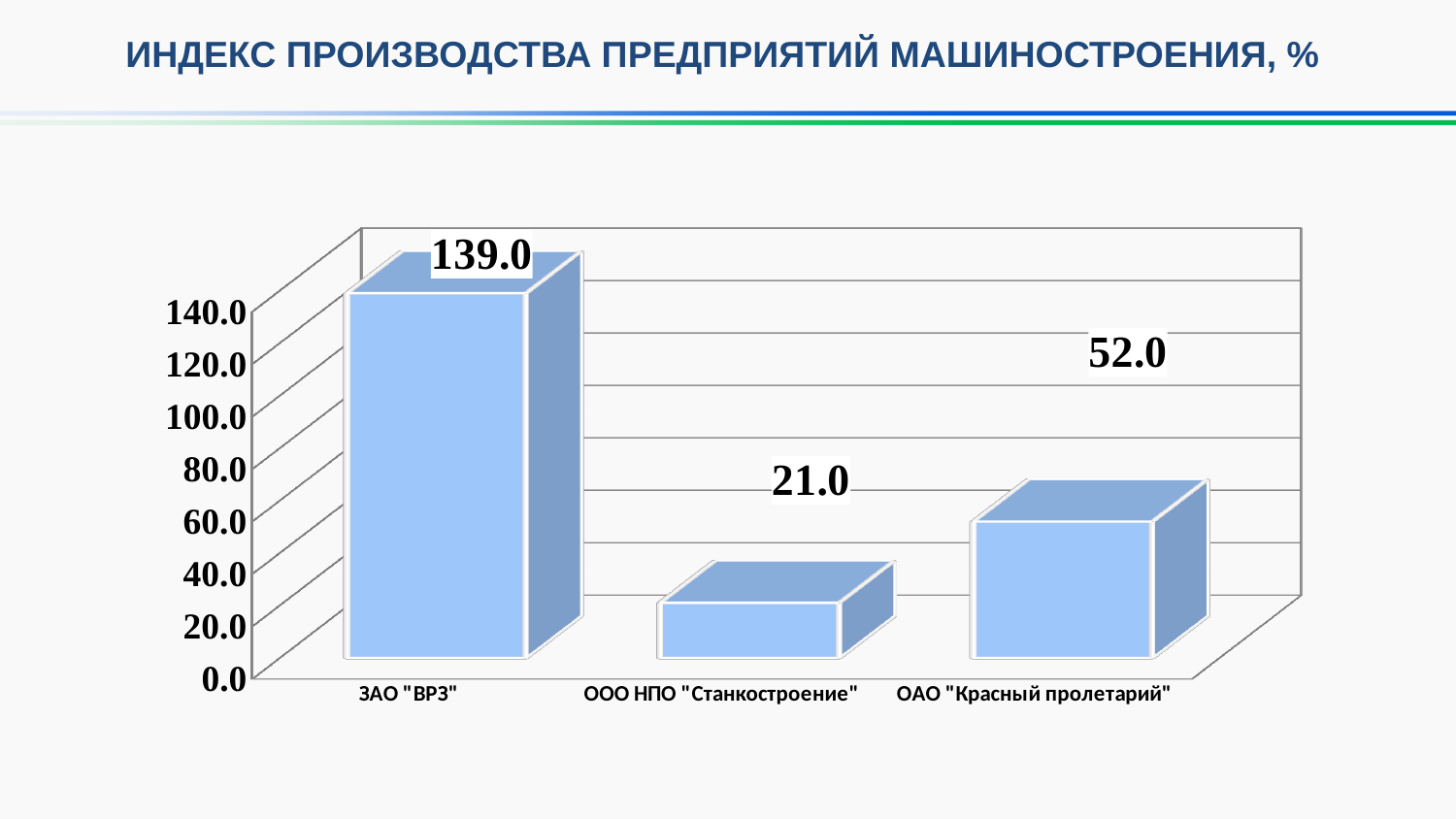
What is the value for ОАО "Красный пролетарий"? 52.0 Which enterprise has the lowest production index? ООО НПО "Станкостроение" What is the difference between the values for ЗАО "ВРЗ" and ОАО "Красный пролетарий"? 87.0 What is the value for ЗАО "ВРЗ"? 139.0 What is the value for ООО НПО "Станкостроение"? 21.0 What is the difference between the values for ОАО "Красный пролетарий" and ООО НПО "Станкостроение"? 31.0 What kind of chart is shown on the slide? bar chart What is the title of the slide? ИНДЕКС ПРОИЗВОДСТВА ПРЕДПРИЯТИЙ МАШИНОСТРОЕНИЯ, % Which enterprise has the highest production index? ЗАО "ВРЗ" How many enterprises are shown on the chart? 3 Is the value for ЗАО "ВРЗ" greater or less than 100.0? greater Which is larger, the value for ОАО "Красный пролетарий" or the value for ООО НПО "Станкостроение"? ОАО "Красный пролетарий"